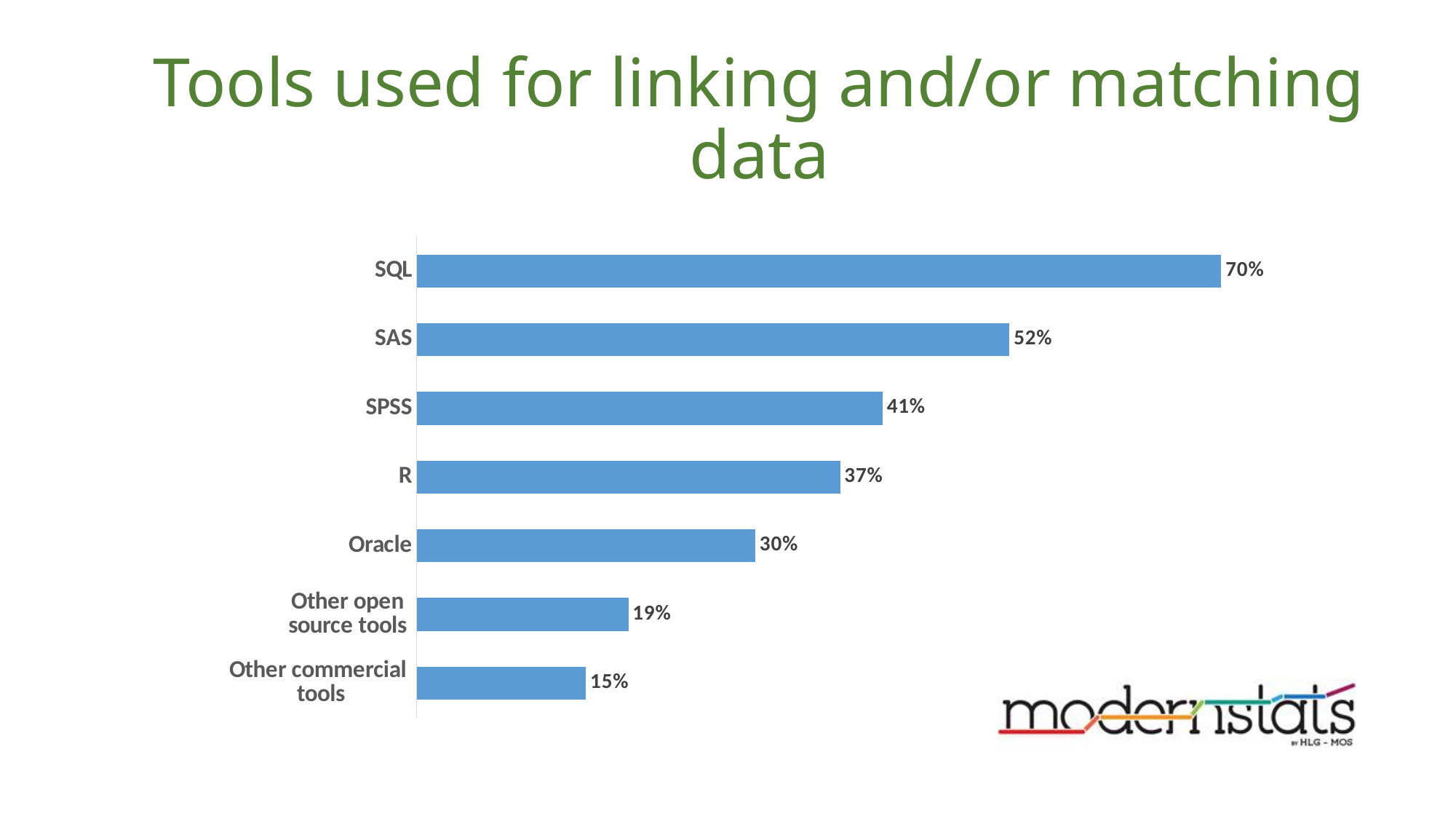
Which tool has the lowest percentage? Other commercial tools What percentage is shown for SQL? 70% What percentage is shown for Oracle? 30% Which has a larger percentage, R or Oracle? R What is the difference between the percentages for SPSS and R? 4% How many tools are shown in the chart? 7 What is the title of the slide? Tools used for linking and/or matching data What kind of chart is shown on the slide? Bar chart What is the difference between the percentages for SQL and SAS? 18% What percentage is shown for Other open source tools? 19% Which tool has the highest percentage? SQL What percentage is shown for SAS? 52%